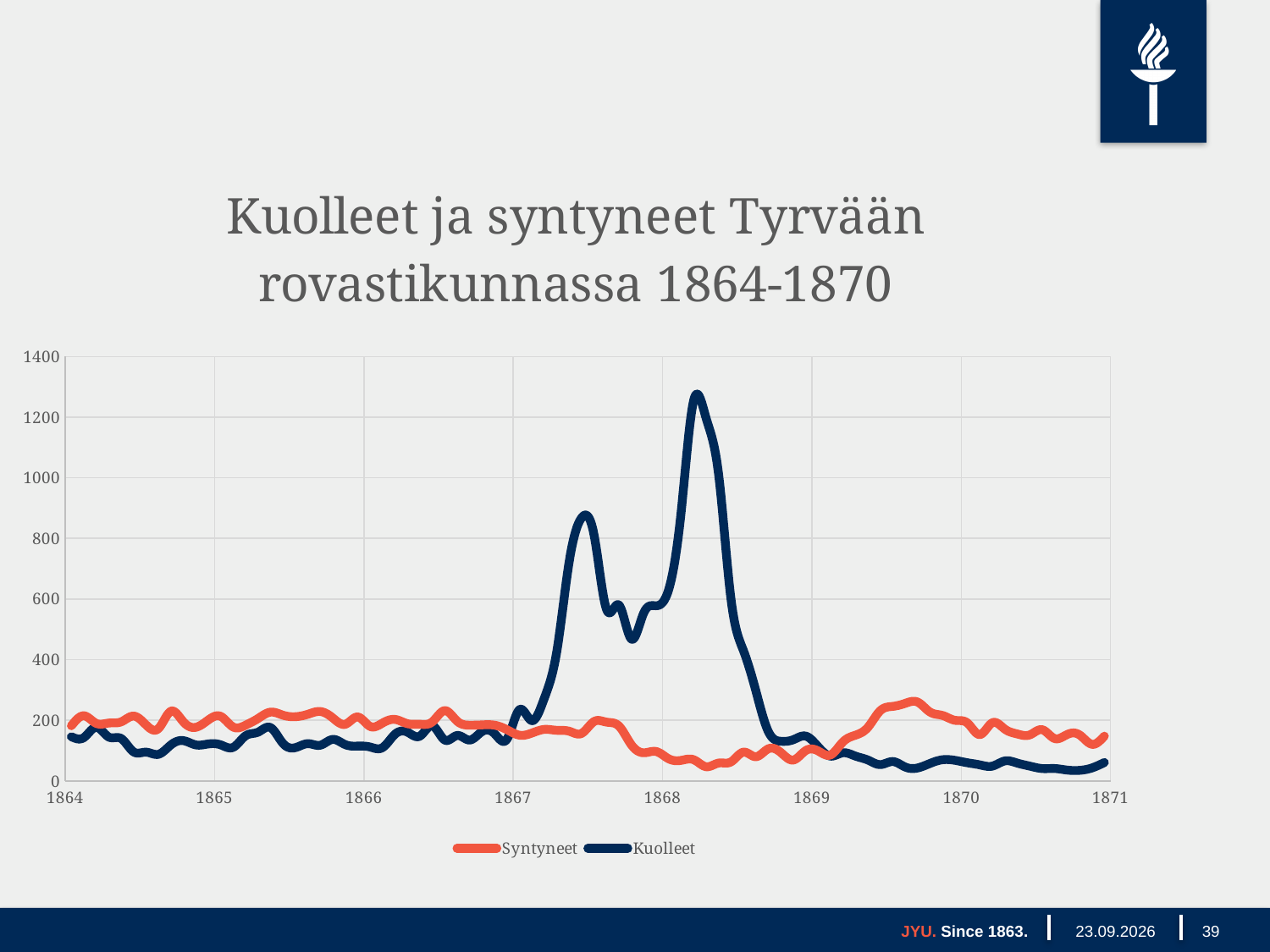
Is the value of Kuolleet at the 1871 tick greater or less than 200? less What kind of chart is shown on the slide? line chart What is the title of the chart? Kuolleet ja syntyneet Tyrvään rovastikunnassa 1864-1870 How many series does the legend list? 2 Is the value of Kuolleet at the 1868 tick greater or less than 400? greater Between the middle of 1868 and the 1869 tick, does the Kuolleet series rise or fall? fall What are the two series named in the legend? Syntyneet and Kuolleet Which series reaches the highest value on the chart? Kuolleet Is the highest value of the Syntyneet series greater or less than 400? less How many year labels are shown on the x axis? 8 In the middle of 1868, which series has the higher value, Syntyneet or Kuolleet? Kuolleet